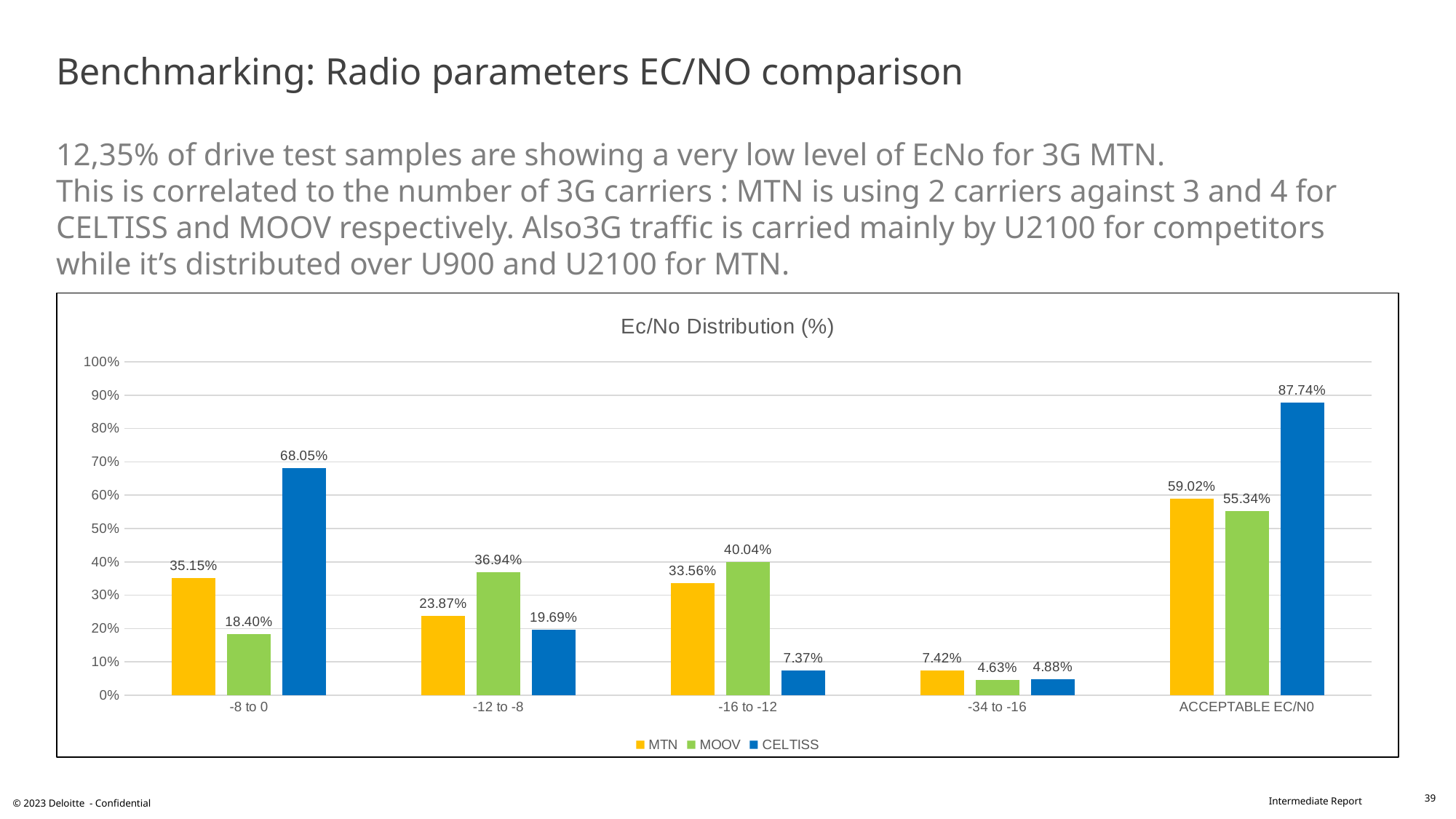
How many series does the legend list? 3 What is the difference between the CELTISS and MTN values in the ACCEPTABLE EC/N0 category? 28.72% What is the CELTISS value for the ACCEPTABLE EC/N0 category? 87.74% What is the MTN value for the -12 to -8 category? 23.87% Which is larger in the -12 to -8 category, the MTN value or the MOOV value? MOOV Which series has the highest value in the -8 to 0 category? CELTISS What is the MOOV value for the -16 to -12 category? 40.04% Is the CELTISS value for the -8 to 0 category greater or less than 60%? greater What kind of chart is shown on the slide? Bar chart Which series has the lowest value in the -34 to -16 category? MOOV What is the title of the chart? Ec/No Distribution (%) How many categories are shown on the x axis? 5